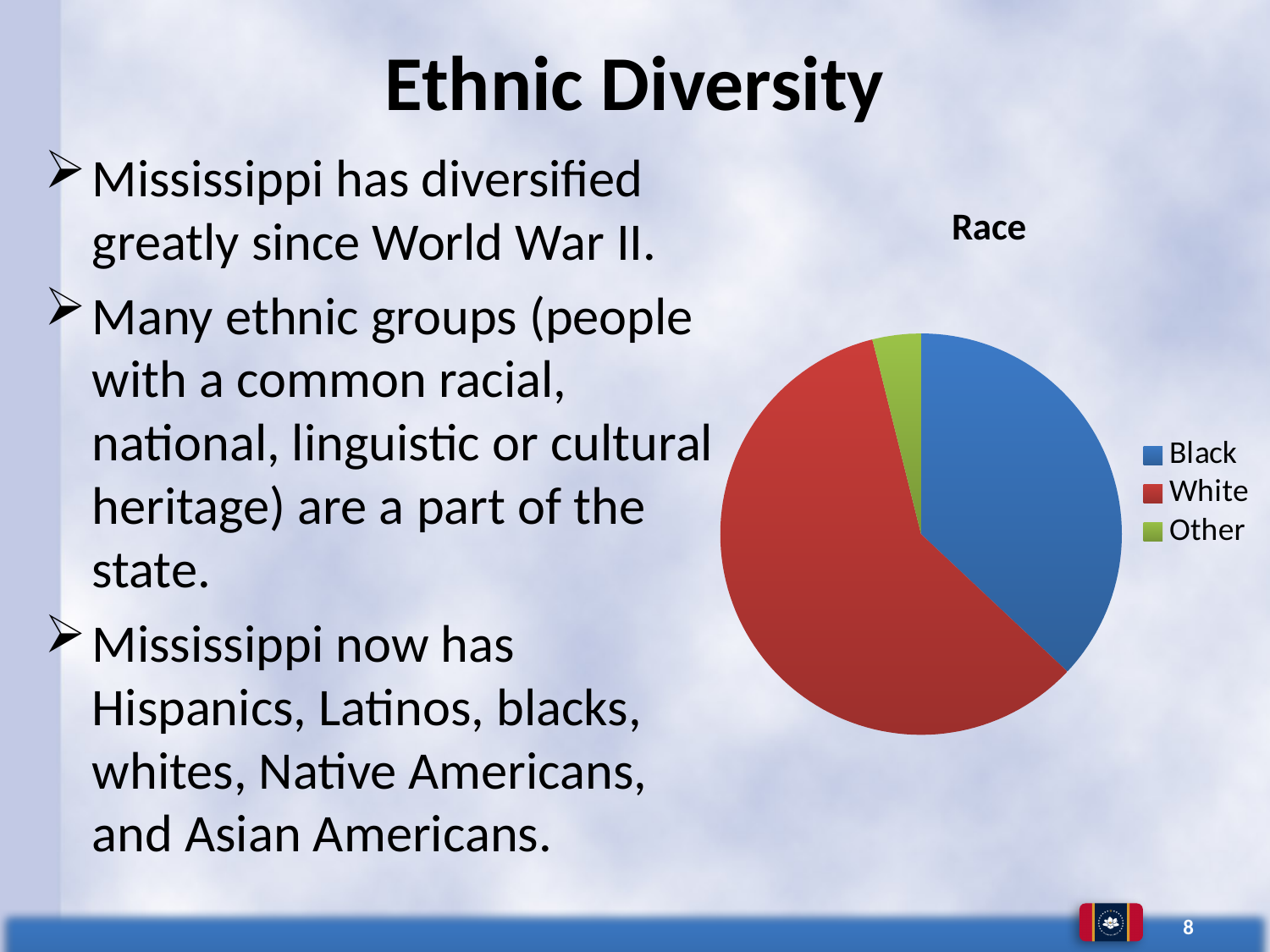
How many entries does the legend list? 3 Which slice is smaller, White or Other? Other Which slice is larger, Black or Other? Black Which category is shown in green? Other What is the title of the chart? Race What kind of chart is shown on the slide? pie chart Which category has the smallest slice of the pie? Other Which slice is larger, Black or White? White What colour is the slice for Black? blue Which category has the largest slice of the pie? White How many categories does the pie chart show? 3